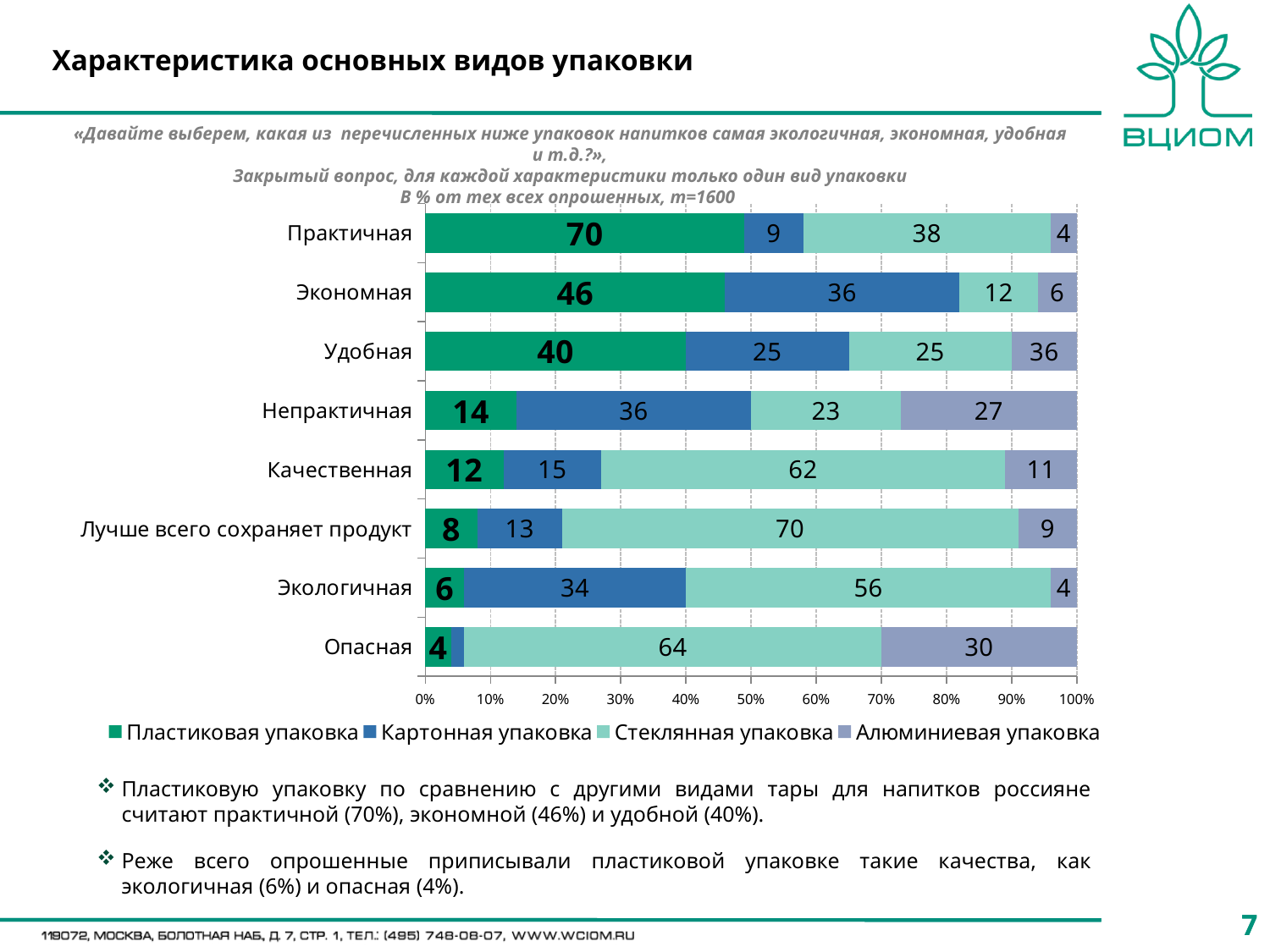
What is the value for Пластиковая упаковка in the Практичная category? 70 Which category has the lowest value for Пластиковая упаковка? Опасная What is the difference between the Картонная упаковка values for Экономная and Практичная? 27 What is the value for Стеклянная упаковка in the Качественная category? 62 Which series is listed first in the legend? Пластиковая упаковка Which category has the larger value for Стеклянная упаковка: Лучше всего сохраняет продукт or Экологичная? Лучше всего сохраняет продукт Which category has the highest value for Пластиковая упаковка? Практичная What kind of chart is shown on the slide? bar chart How many series does the legend list? 4 How many categories (characteristics) are plotted on the chart? 8 What is the value for Картонная упаковка in the Непрактичная category? 36 What is the value for Алюминиевая упаковка in the Опасная category? 30